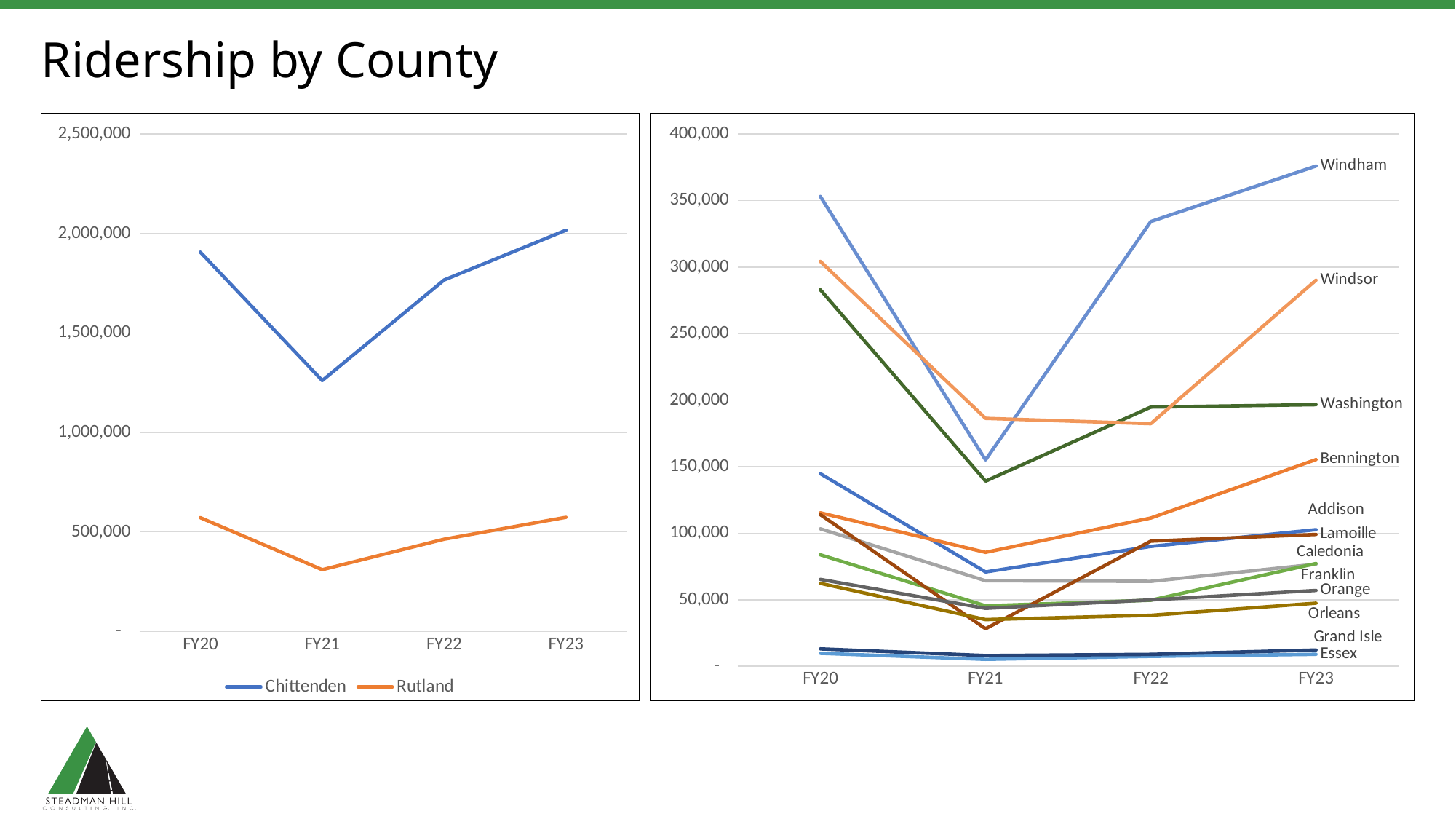
In the left chart, does the Chittenden line rise or fall from FY21 to FY23? rise In the right chart, is the value for Washington in FY21 greater or less than 150,000? less What kind of chart is the left chart on the slide? line chart In the left chart, is the value for Rutland in FY20 greater or less than 500,000? greater In the left chart, is the value for Chittenden in FY21 greater or less than 1,500,000? less How many series does the legend of the left chart list? 2 In the right chart, which county has the lowest value in FY23? Essex In the right chart, does the Windham line rise or fall from FY20 to FY21? fall In the left chart, which series has the higher value in FY23, Chittenden or Rutland? Chittenden How many fiscal years are shown on the x axis of the left chart? 4 In the right chart, which county has the highest value in FY23? Windham